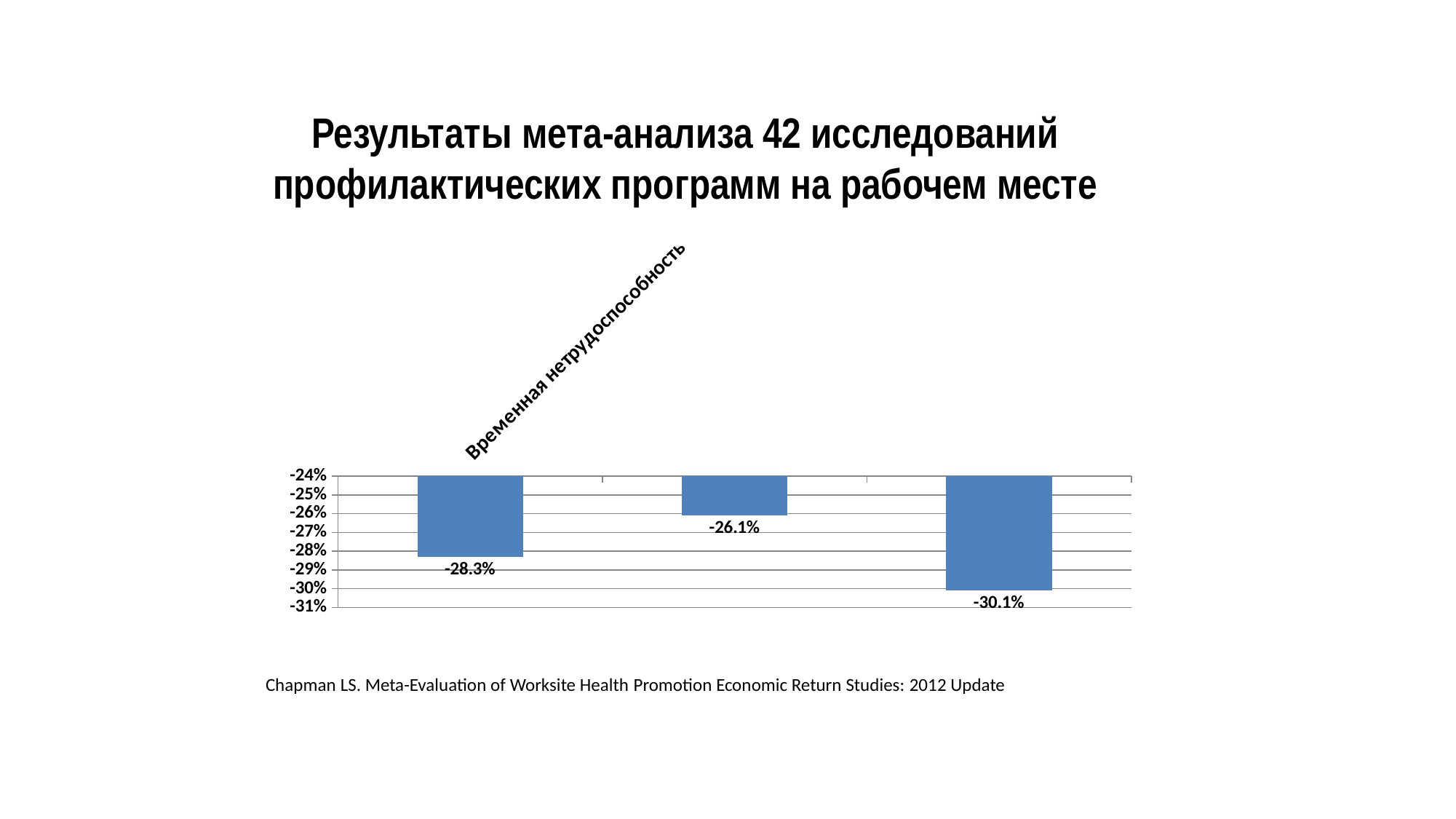
What is the lowest value shown on the vertical axis of the chart? -31% What is the value shown on the middle bar of the chart? -26.1% Which bar has the lowest (most negative) value? The right bar (-30.1%) How many bars are plotted in the chart? 3 Which bar has the larger value, the left bar or the middle bar? The middle bar What is the title of the slide containing the chart? Результаты мета-анализа 42 исследований профилактических программ на рабочем месте What is the difference between the middle bar (-26.1%) and the right bar (-30.1%)? 4.0 percentage points What is the value shown on the left bar of the chart? -28.3% What is the difference between the left bar (-28.3%) and the right bar (-30.1%)? 1.8 percentage points What type of chart is shown on the slide? Bar chart What is the value shown on the right bar of the chart? -30.1% Which bar has the highest (least negative) value? The middle bar (-26.1%)